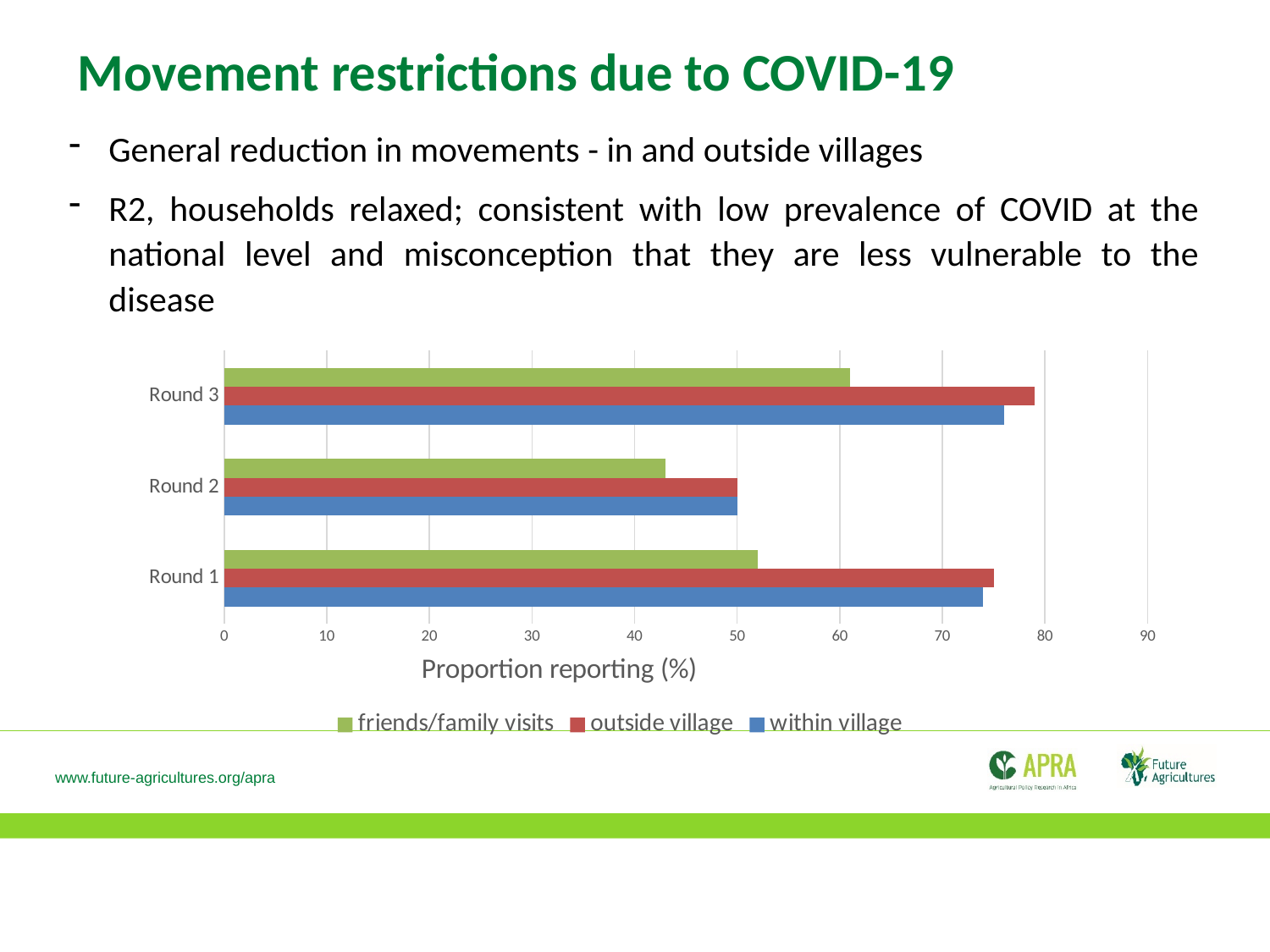
Is the value for within village in Round 1 greater or less than 70? greater Is the value for friends/family visits in Round 2 greater or less than 50? less Which round has the lowest value for within village? Round 2 How many series does the chart's legend list? 3 What kind of chart is shown on the slide? bar chart Is the value for outside village in Round 3 greater or less than 70? greater Which round has the highest value for friends/family visits? Round 3 What is the title of the horizontal axis? Proportion reporting (%) Which round has the lowest value for friends/family visits? Round 2 Which is larger: outside village in Round 1 or outside village in Round 2? Round 1 What colour represents the within village series in the legend? blue How many rounds (categories) are shown on the chart? 3